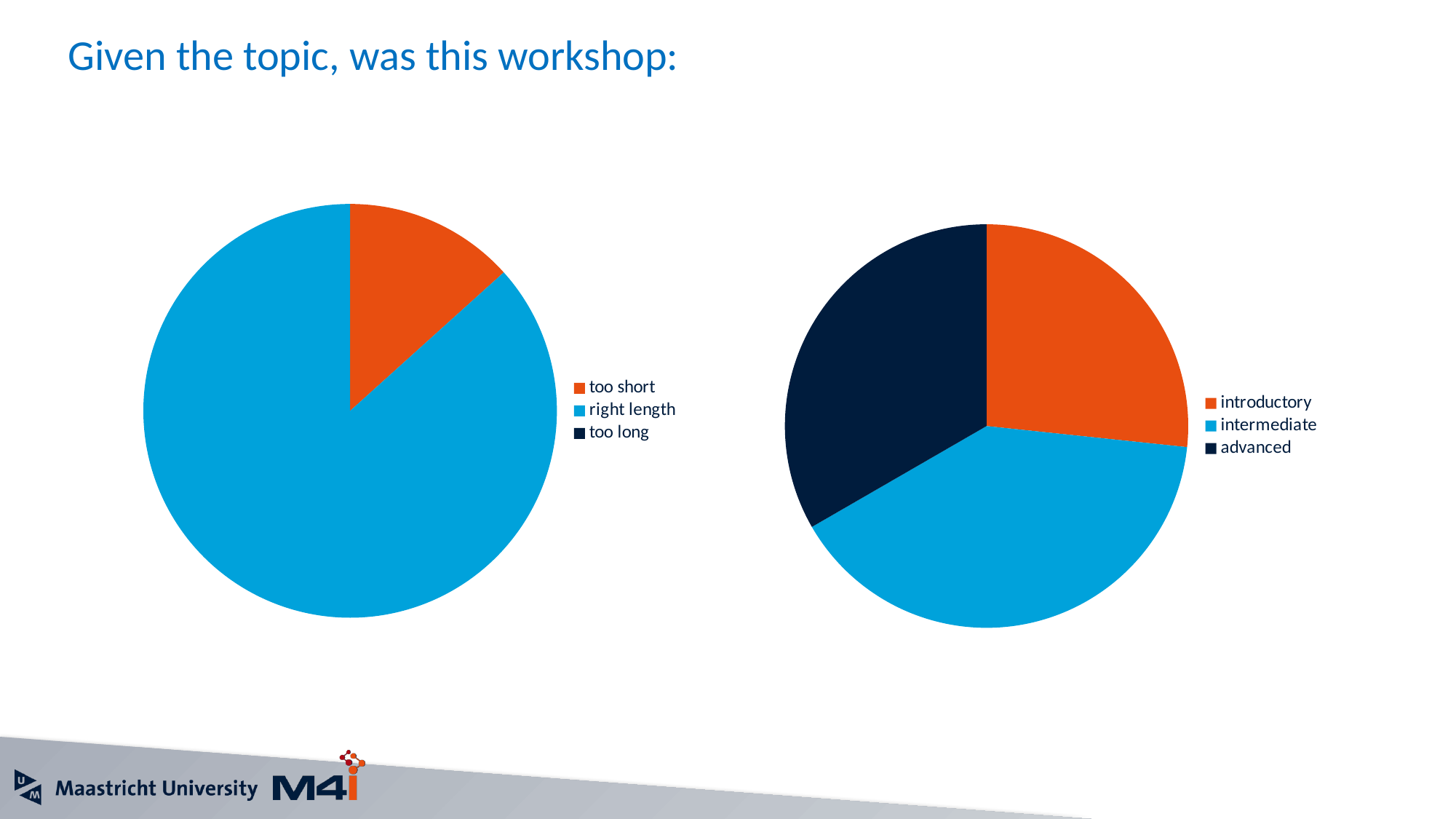
In the left pie chart, which of the two visible slices is larger, too short or right length? right length In the right pie chart, which slice is larger, intermediate or advanced? intermediate In the right pie chart, which slice is larger, introductory or intermediate? intermediate What is the title shown above the charts on the slide? Given the topic, was this workshop: What kind of chart is the right chart on the slide? pie chart What kind of chart is the left chart on the slide? pie chart In the right pie chart, which category has the smallest slice? introductory In the left pie chart, which category has the largest slice? right length In the left pie chart, how many entries does the legend list? 3 In the right pie chart, how many entries does the legend list? 3 In the left pie chart, what colour is the slice for too short? orange In the right pie chart, which category has the largest slice? intermediate